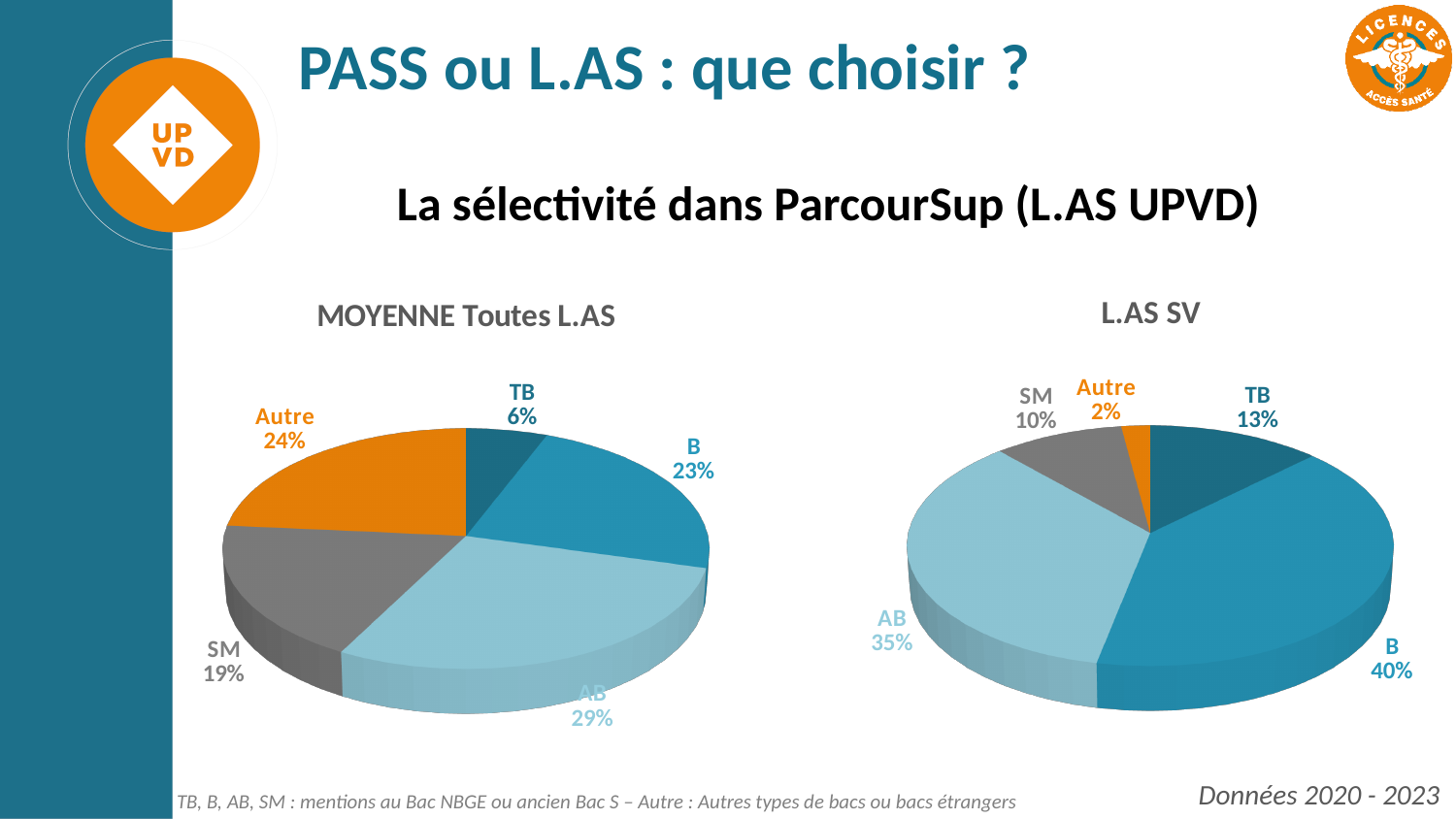
In the 'MOYENNE Toutes L.AS' chart, what is the difference between the shares for Autre and TB? 18% What is the title of the chart on the right side of the slide? L.AS SV In the 'L.AS SV' chart, which category has the largest share? B In the 'L.AS SV' chart, what is the share for B? 40% In the 'MOYENNE Toutes L.AS' chart, what is the share for AB? 29% How many slices does the 'L.AS SV' pie chart have? 5 What kind of chart is the 'MOYENNE Toutes L.AS' chart? Pie chart In the 'L.AS SV' chart, which category has the smallest share? Autre In the 'L.AS SV' chart, which is larger, the share for SM or the share for TB? TB In the 'L.AS SV' chart, what is the difference between the shares for B and AB? 5% In the 'MOYENNE Toutes L.AS' chart, which category has the smallest share? TB In the 'MOYENNE Toutes L.AS' chart, which is larger, the share for Autre or the share for B? Autre